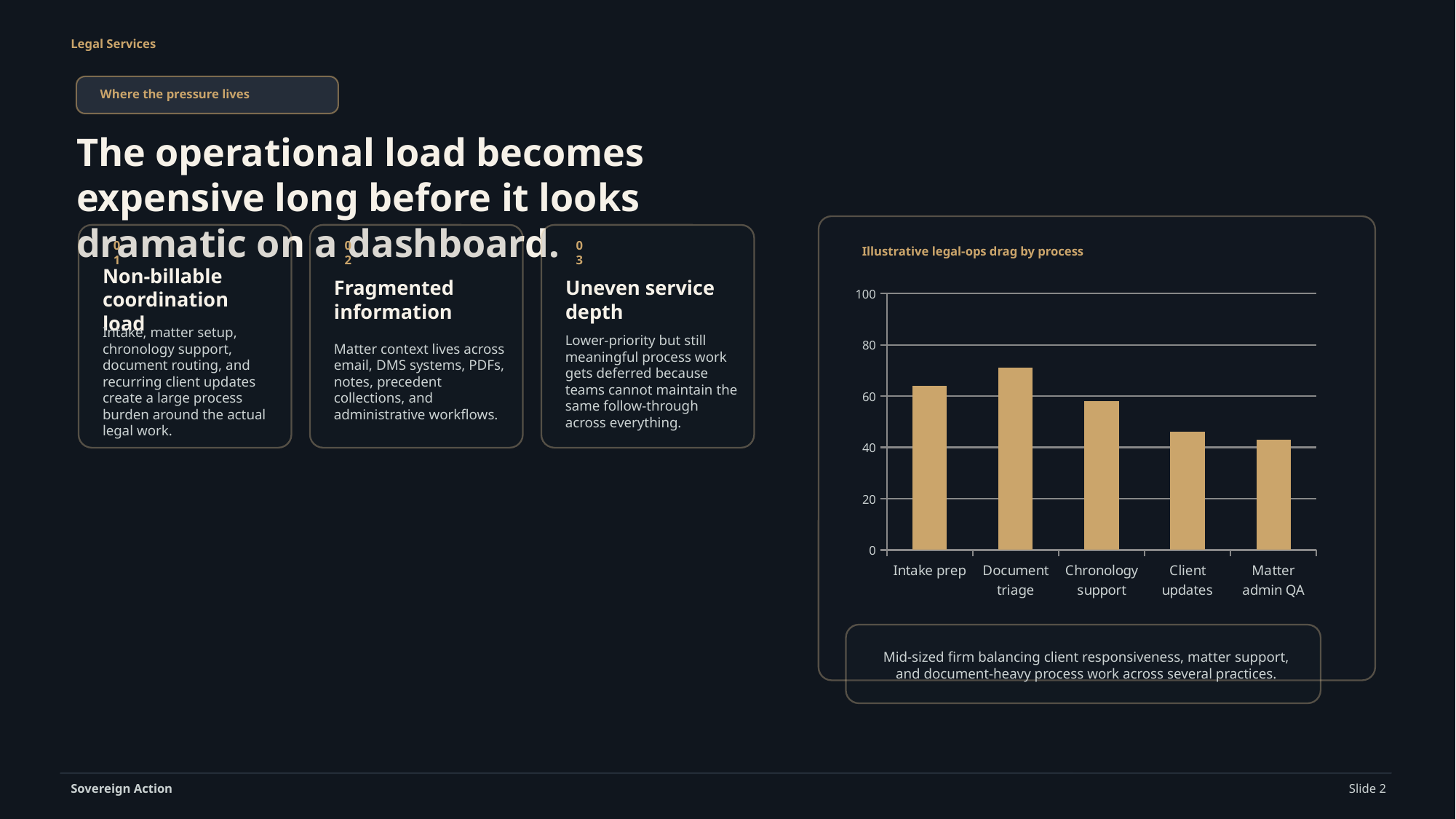
Is the value for Document triage greater or less than 80? less What is the highest value shown on the chart's vertical axis? 100 What is the title of the chart on the slide? Illustrative legal-ops drag by process How many process categories are plotted on the chart? 5 Is the value for Chronology support greater or less than 40? greater Which is larger, the value for Intake prep or the value for Chronology support? Intake prep From Document triage to Matter admin QA, do the values rise or fall along the x axis? fall Is the value for Client updates greater or less than 60? less What kind of chart is shown on the slide? bar chart Which is larger, the value for Document triage or the value for Client updates? Document triage Which process has the highest value on the chart? Document triage